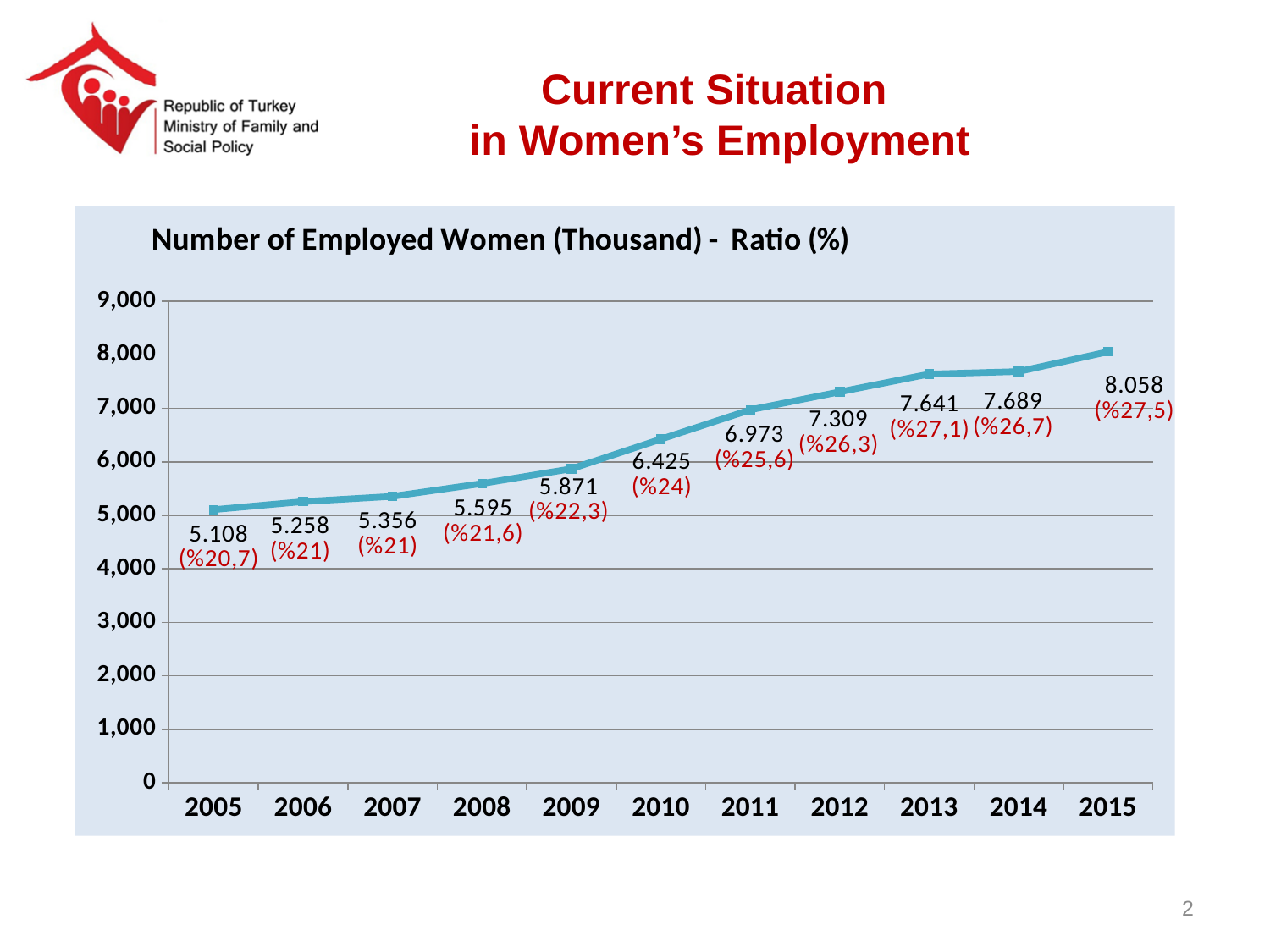
Is the value for 2008 greater or less than 6,000? less Which year has the highest number of employed women? 2015 How many years are plotted on the x axis? 11 What is the number of employed women (thousand) shown for 2005? 5.108 Is the value for 2013 greater or less than 7,000? greater What is the title of the chart? Number of Employed Women (Thousand) - Ratio (%) What is the number of employed women (thousand) shown for 2010? 6.425 What kind of chart is shown on the slide? Line chart Which year has the lowest number of employed women? 2005 Does the number of employed women rise or fall from 2005 to 2015? Rise What ratio (%) is shown for 2015? %27,5 Which year has a higher number of employed women, 2009 or 2012? 2012